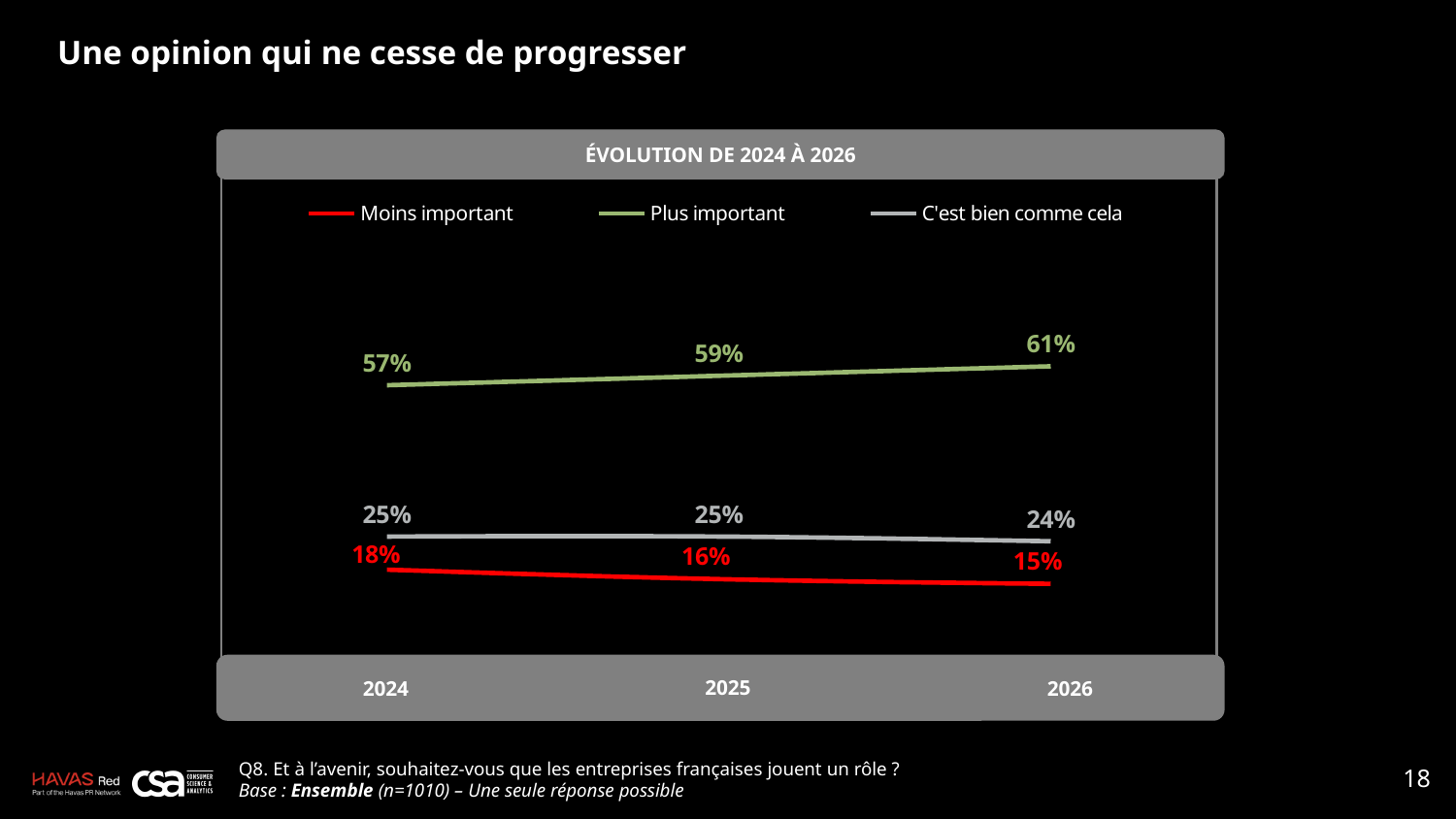
How many series does the legend list? 3 Which is larger in 2026: "C'est bien comme cela" or "Moins important"? C'est bien comme cela What kind of chart is shown? Line chart How many years are shown on the x axis? 3 What is the value for "Moins important" in 2024? 18% What is the value for "Plus important" in 2026? 61% What is the value for "Plus important" in 2024? 57% In which year is "Moins important" lowest? 2026 Does the "Moins important" series rise or fall from 2024 to 2026? Fall What is the difference between the "Plus important" values in 2026 and 2024? 4 percentage points In which year is "Plus important" highest? 2026 What is the value for "C'est bien comme cela" in 2025? 25%